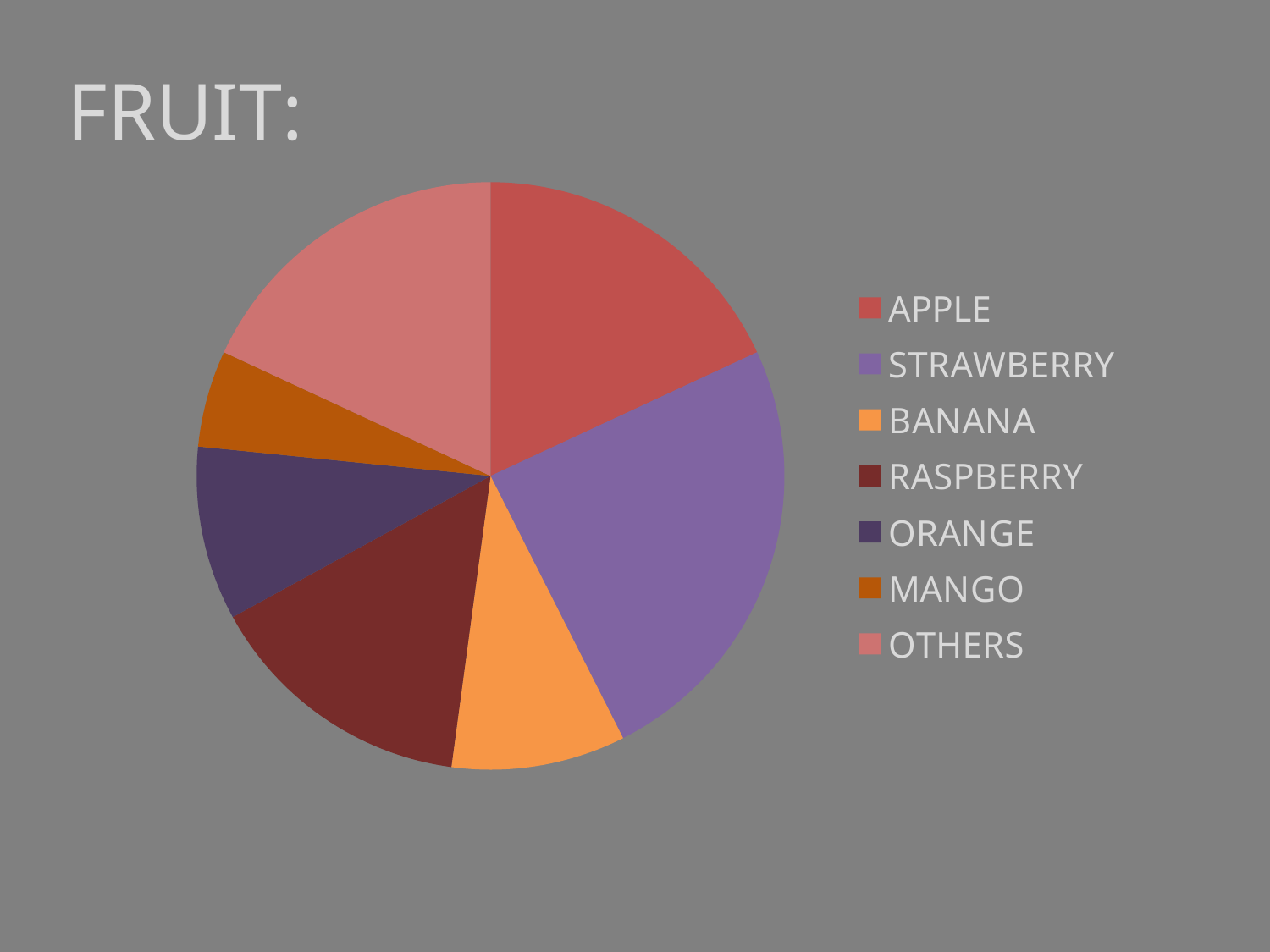
Which slice is larger, MANGO or ORANGE? ORANGE How many categories does the pie chart show? 7 What kind of chart is shown on the slide? pie chart Which slice is larger, RASPBERRY or BANANA? RASPBERRY Which category has the smallest slice of the pie chart? MANGO Which slice is larger, OTHERS or MANGO? OTHERS What is the title of the slide containing the pie chart? FRUIT: Which category is listed last in the legend of the pie chart? OTHERS Which category has the largest slice of the pie chart? STRAWBERRY